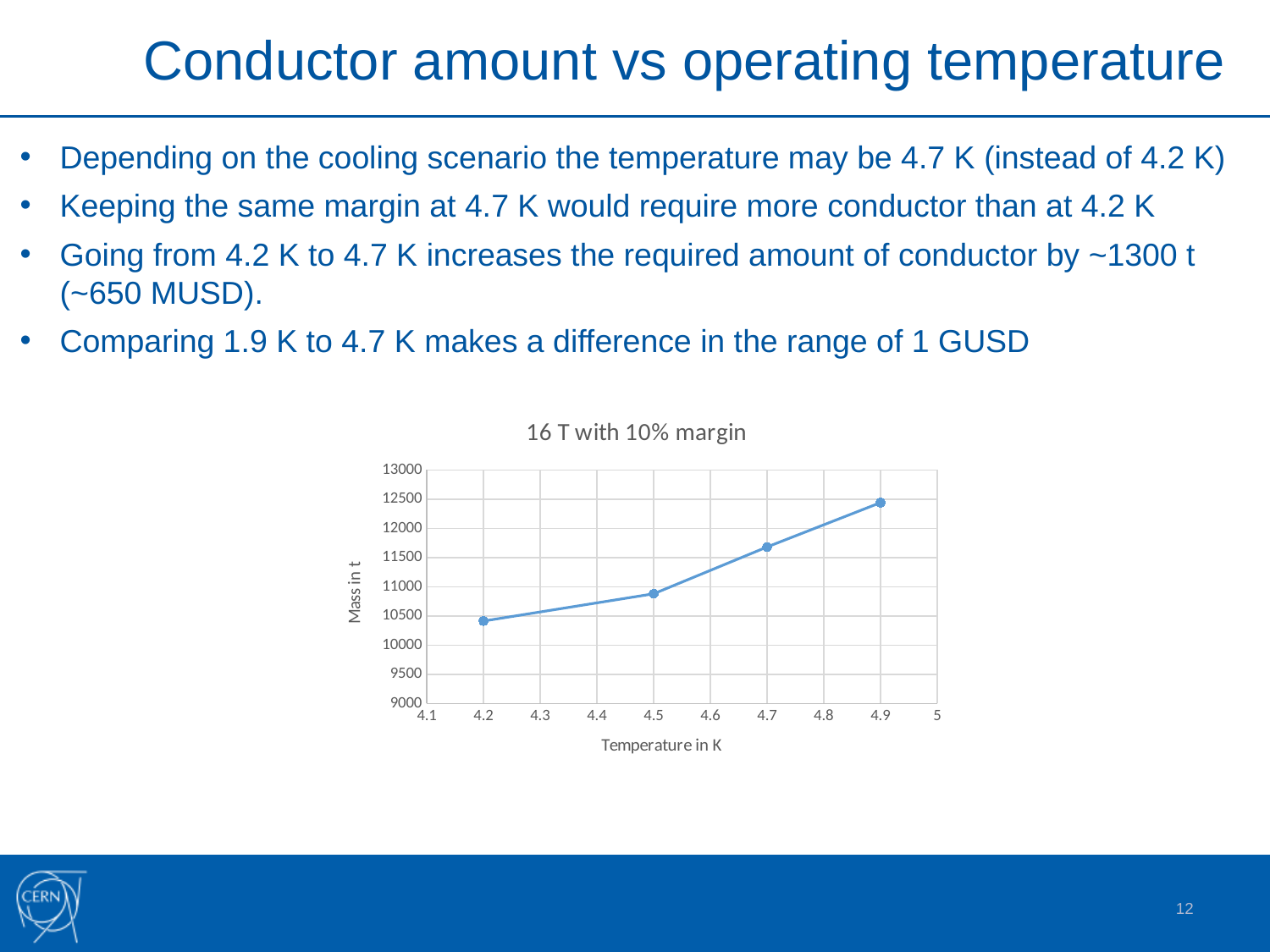
Is the mass value at 4.5 K greater or less than 11000? less At which temperature is the plotted mass lowest? 4.2 At which temperature is the plotted mass highest? 4.9 Is the mass value at 4.9 K greater or less than 12000? greater Which has the larger mass value, 4.5 K or 4.7 K? 4.7 K What kind of chart is shown on the slide? line chart Is the mass value at 4.7 K greater or less than 11500? greater How many data points are plotted on the chart? 4 What is the label of the vertical axis of the chart? Mass in t What is the title of the chart? 16 T with 10% margin Do the plotted mass values rise or fall as the temperature increases along the x axis? rise